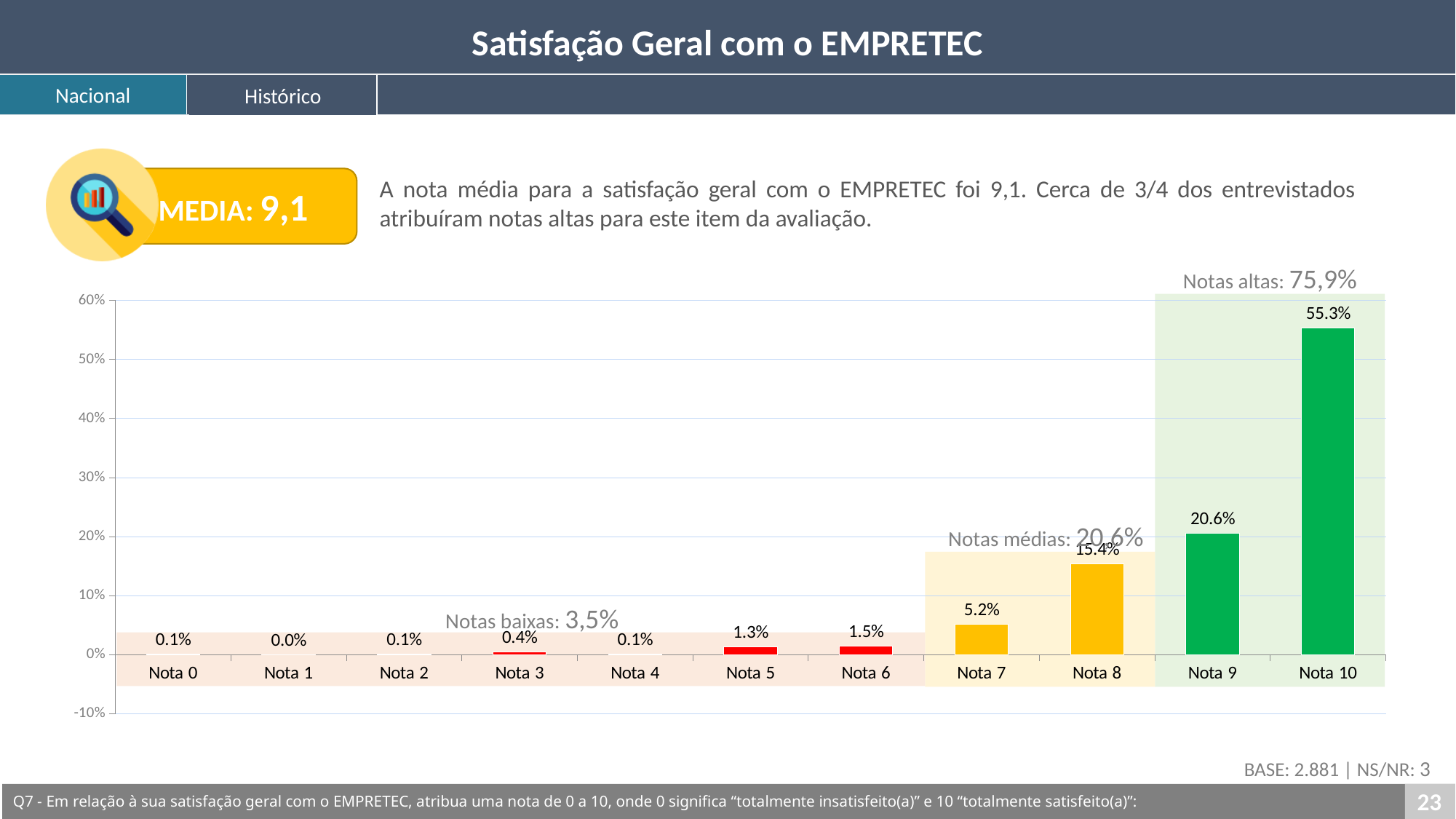
What is the value for Nota 8? 15.4% What kind of chart is shown on the slide? bar chart What is the average score (MEDIA) shown on the slide? 9,1 What is the value for Nota 10? 55.3% What percentage is shown for 'Notas altas' on the chart? 75,9% Which category has the highest value? Nota 10 Which category has the lowest value? Nota 1 What is the value for Nota 5? 1.3% Is the value for Nota 10 greater or less than 50%? greater What is the difference between the values for Nota 10 and Nota 9? 34.7% Which is larger, the value for Nota 7 or the value for Nota 8? Nota 8 How many categories are shown on the x axis? 11